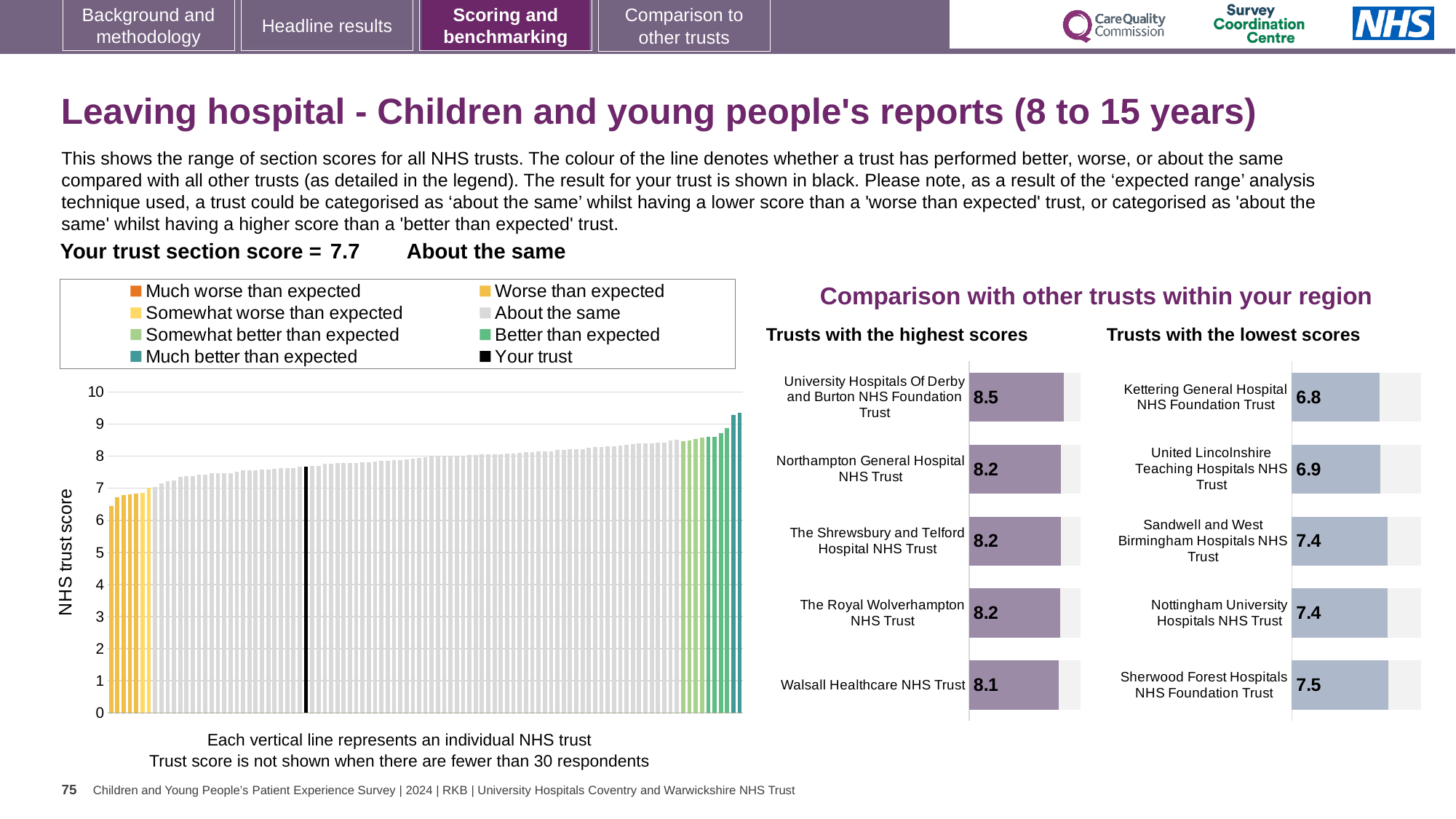
In the 'Trusts with the highest scores' chart, what is the difference between the scores of University Hospitals Of Derby and Burton NHS Foundation Trust and Walsall Healthcare NHS Trust? 0.4 In the 'Trusts with the lowest scores' chart, which trust has the highest score? Sherwood Forest Hospitals NHS Foundation Trust What kind of chart is the main NHS trust score chart on the left? Bar chart In the 'Trusts with the lowest scores' chart, which has the higher score: Kettering General Hospital NHS Foundation Trust or United Lincolnshire Teaching Hospitals NHS Trust? United Lincolnshire Teaching Hospitals NHS Trust In the main NHS trust score chart, how many categories does the legend list? 8 In the 'Trusts with the highest scores' chart, which trust has the lowest score? Walsall Healthcare NHS Trust How many trusts are shown in the 'Trusts with the highest scores' chart? 5 In the 'Trusts with the lowest scores' chart, what is the score for Kettering General Hospital NHS Foundation Trust? 6.8 In the 'Trusts with the highest scores' chart, what is the score for University Hospitals Of Derby and Burton NHS Foundation Trust? 8.5 In the main NHS trust score chart, is the value for the black 'Your trust' bar greater or less than 7? greater In the 'Trusts with the lowest scores' chart, what is the difference between the scores of Sherwood Forest Hospitals NHS Foundation Trust and Kettering General Hospital NHS Foundation Trust? 0.7 In the main NHS trust score chart, do the trust scores rise or fall from left to right? Rise